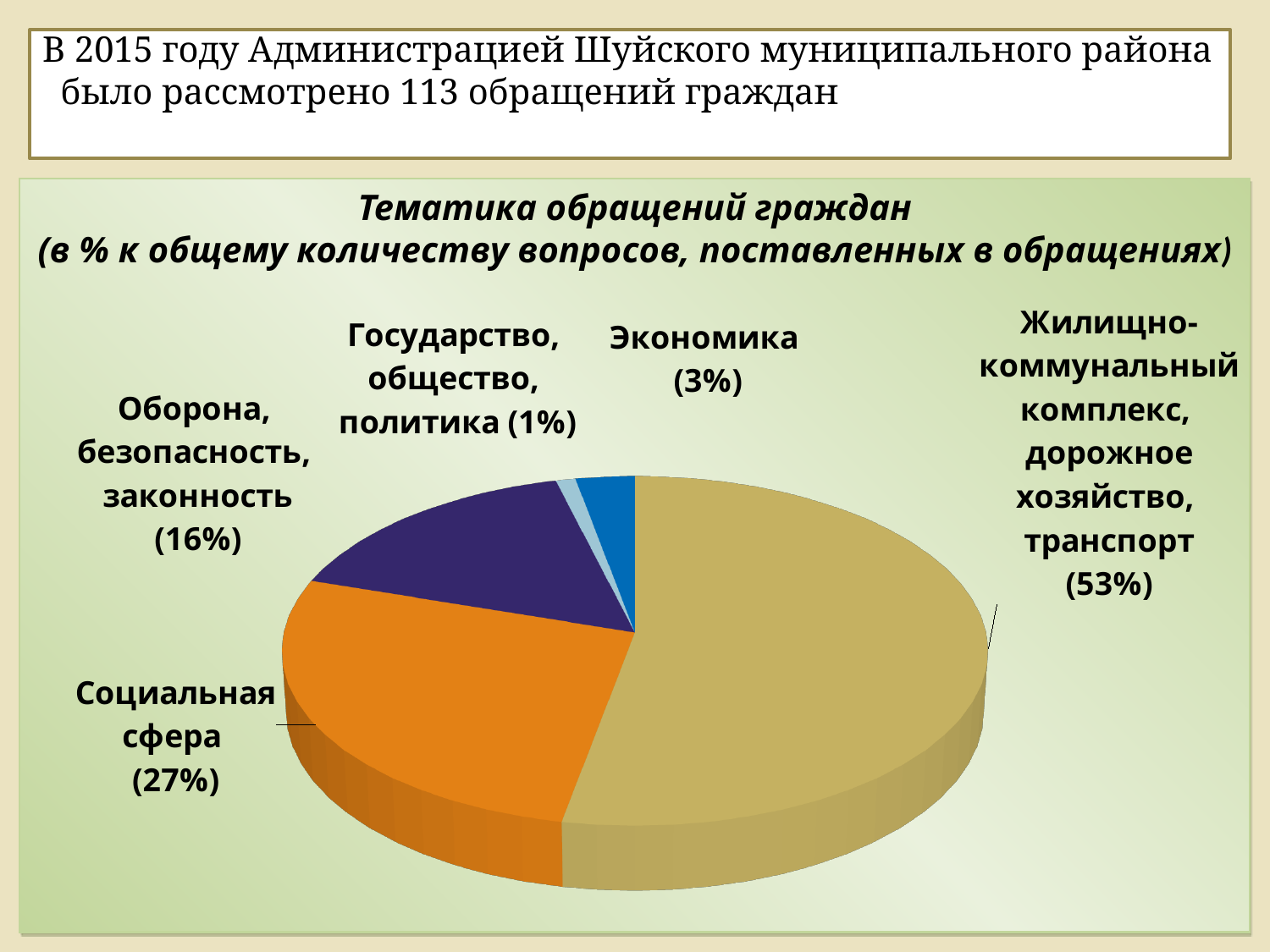
What is the title of the chart? Тематика обращений граждан (в % к общему количеству вопросов, поставленных в обращениях) What kind of chart is shown on the slide? pie chart What is the value for "Государство, общество, политика"? 1% Which is larger: the share for "Экономика" or the share for "Государство, общество, политика"? Экономика How many categories are shown in the pie chart? 5 What is the value for "Экономика"? 3% What is the value for "Социальная сфера"? 27% Which category has the largest share of the pie? Жилищно-коммунальный комплекс, дорожное хозяйство, транспорт Which category has the smallest share of the pie? Государство, общество, политика What share of the pie does "Жилищно-коммунальный комплекс, дорожное хозяйство, транспорт" have? 53% What is the difference between the shares of "Социальная сфера" and "Оборона, безопасность, законность"? 11% What is the value for "Оборона, безопасность, законность"? 16%